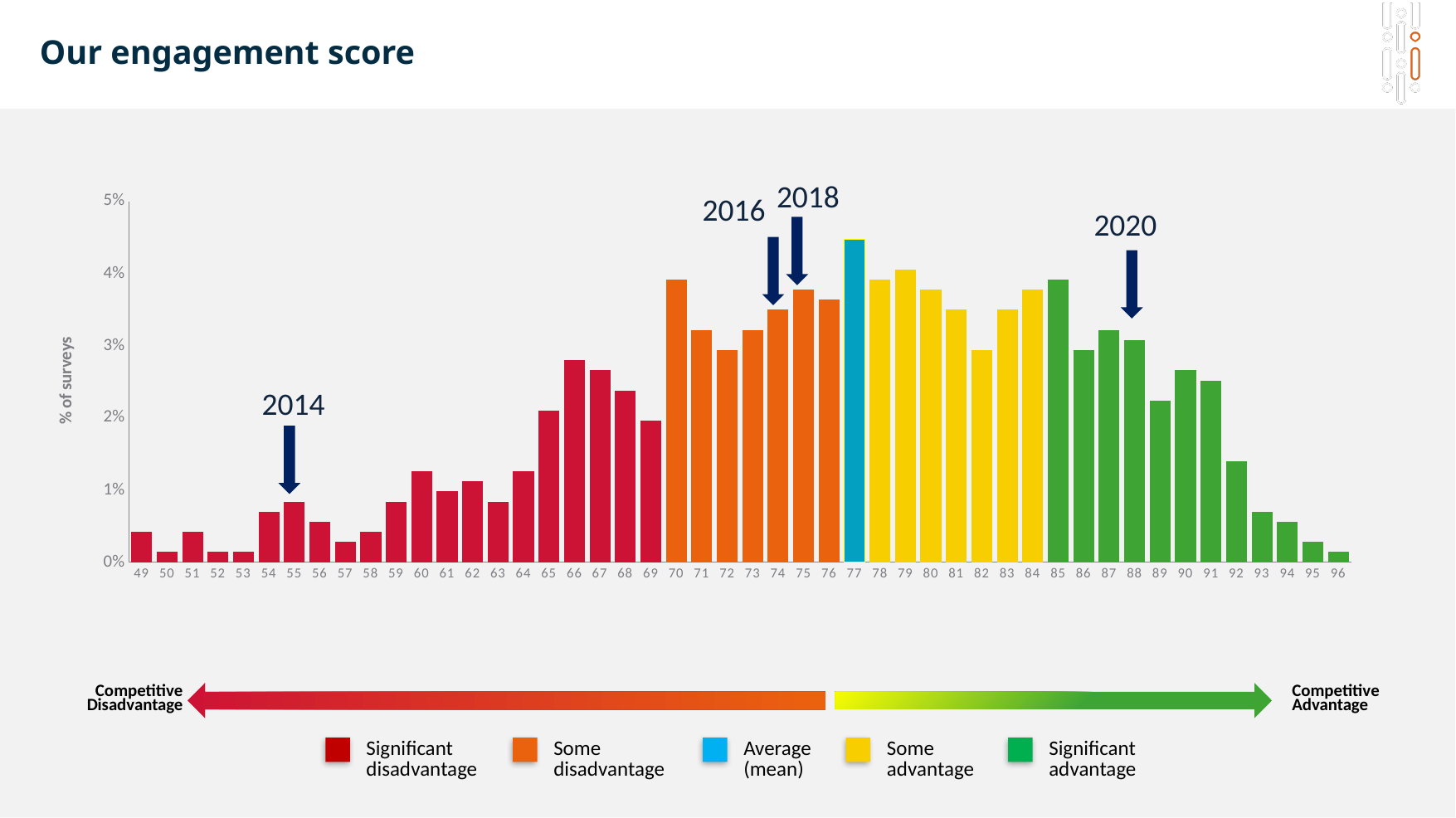
How many entries does the legend list? 5 What is the title of the slide? Our engagement score Is the value for score 92 greater or less than 2%? less Is the value for score 55 greater or less than 1%? less Which has a higher % of surveys, score 69 or score 70? 70 Which score does the 2014 arrow point to? 55 Which legend entry is shown in blue? Average (mean) What kind of chart is shown on the slide? bar chart Is the value for score 77 greater or less than 4%? greater Which score has the highest % of surveys? 77 How many score categories are shown along the x axis? 48 Which score does the 2020 arrow point to? 88